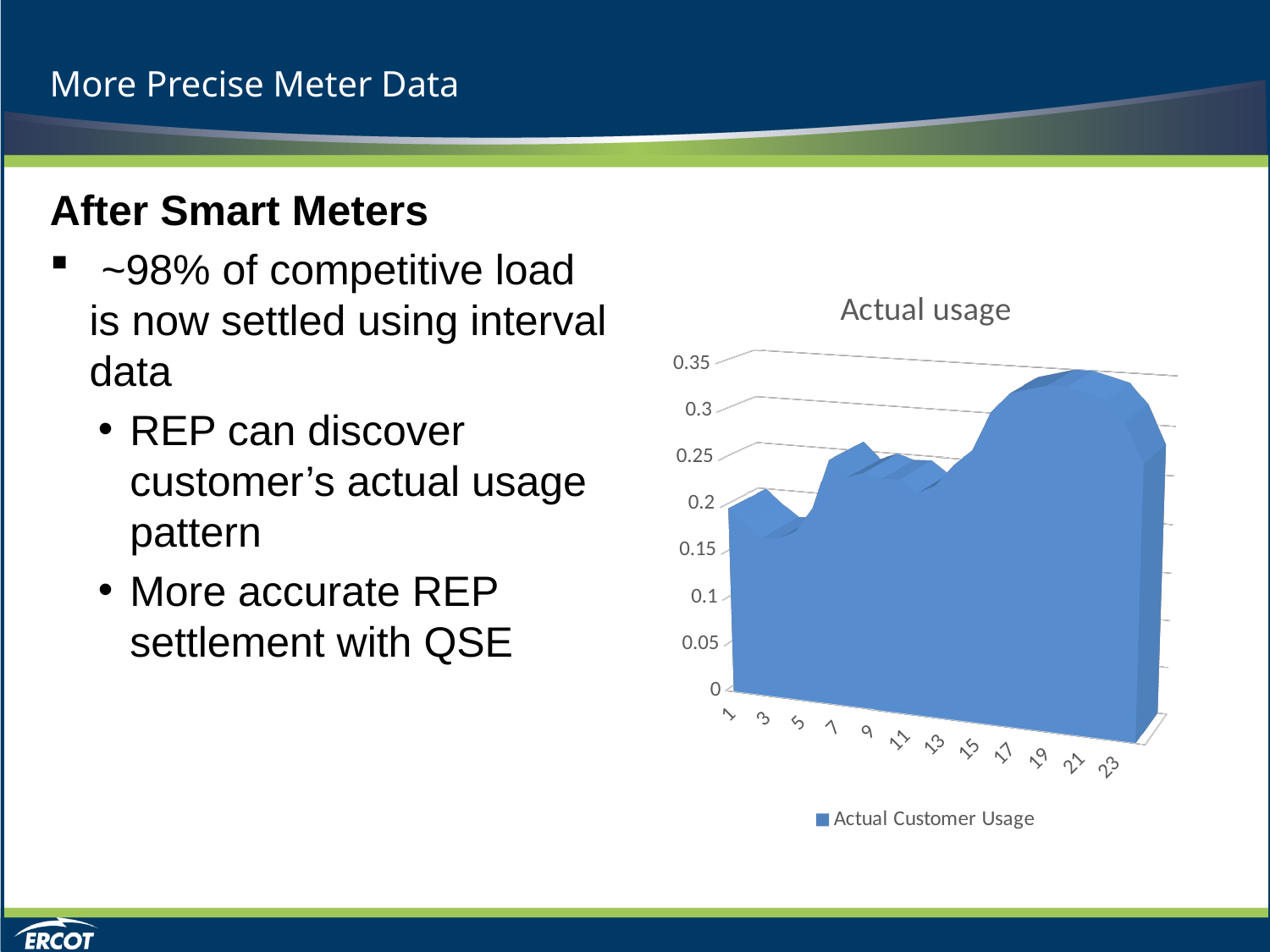
Do the values rise or fall along the x axis from category 13 to category 19? rise What is the highest value shown on the chart's vertical axis? 0.35 Is the value for category 3 greater or less than 0.25? less What kind of chart is shown on the slide? area chart Which has the larger value, category 7 or category 3? 7 Is the value for category 1 greater or less than 0.3? less How many series does the chart legend list? 1 Is the value for category 21 greater or less than 0.3? greater What is the name of the series shown in the chart legend? Actual Customer Usage What is the last category label shown on the chart's horizontal axis? 23 Which has the larger value, category 19 or category 5? 19 What is the title of the chart? Actual usage